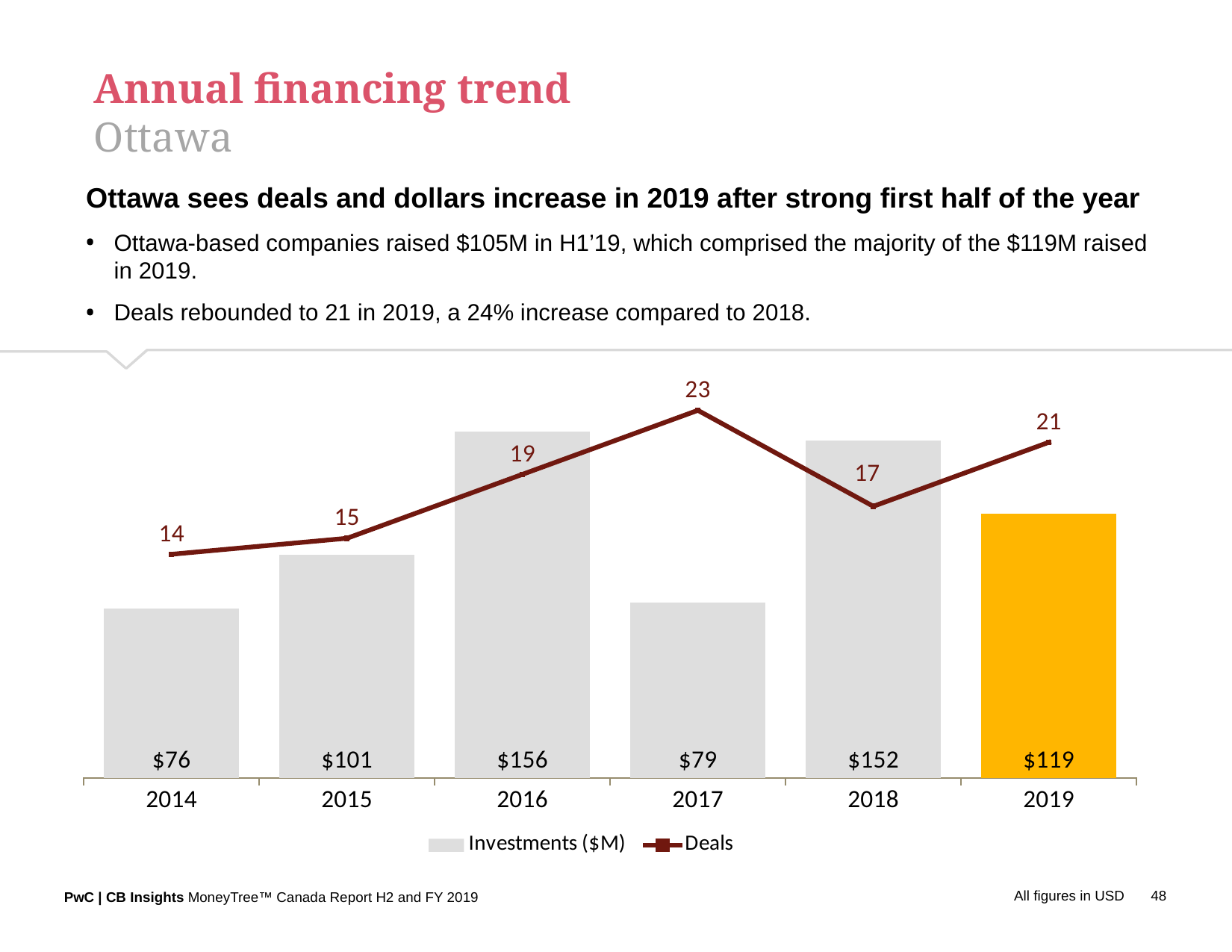
What is the difference in Investments ($M) between 2018 and 2017? $73 How many years are shown on the x axis? 6 Which year has the lowest number of Deals? 2014 What is the value of Investments ($M) for 2016? $156 What kind of chart is used to show Investments ($M)? Bar chart Did the number of Deals rise or fall from 2018 to 2019? Rise How many series does the legend list? 2 What is the difference in Deals between 2017 and 2018? 6 What is the value of Investments ($M) for 2019? $119 Which year had more Deals, 2015 or 2019? 2019 How many Deals were there in 2017? 23 Which year has the highest Investments ($M)? 2016